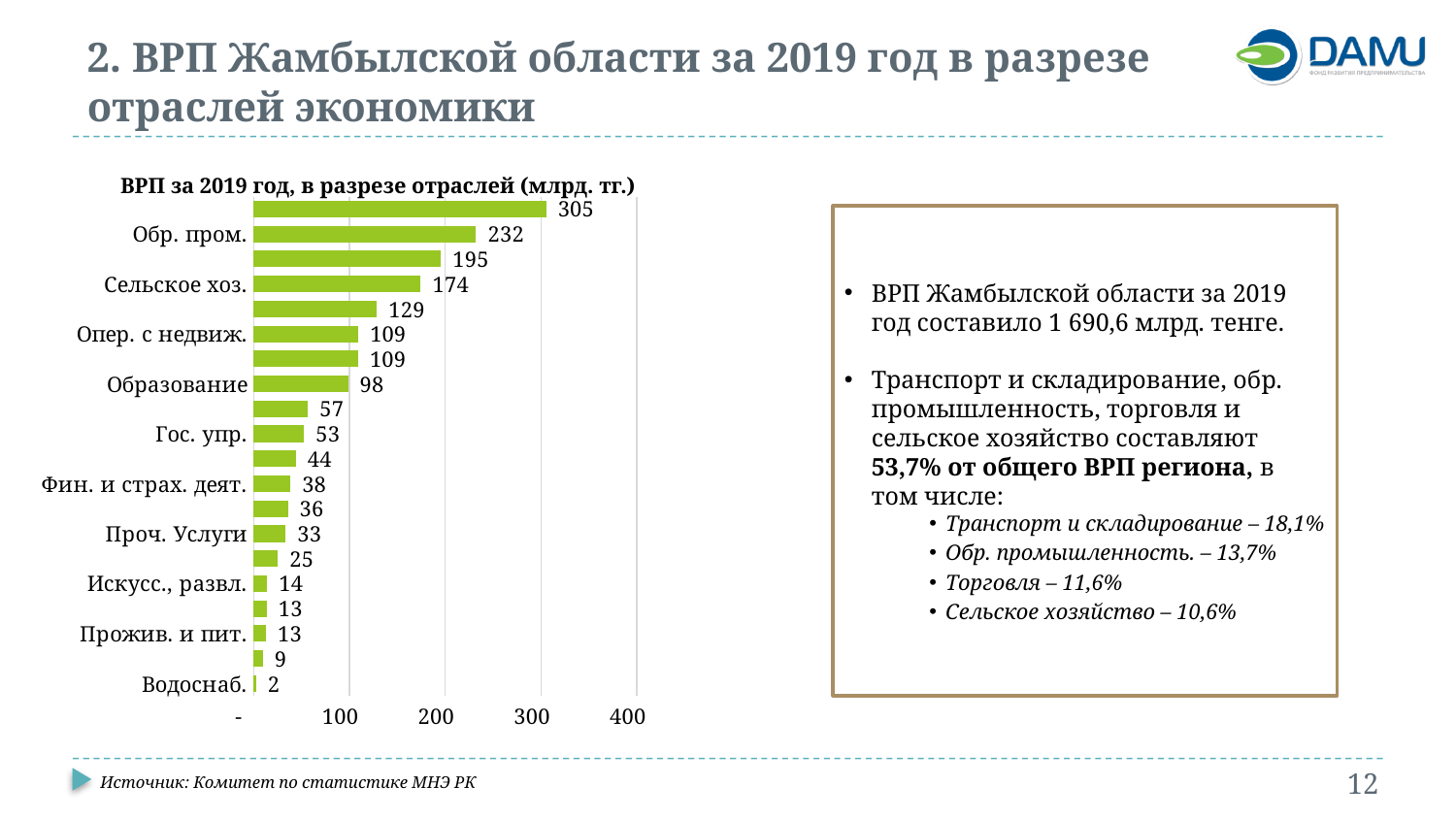
Which is larger, the value for Гос. упр. or the value for Фин. и страх. деят.? Гос. упр. What is the value for Сельское хоз. in the chart? 174 What kind of chart is shown on the slide? bar chart What is the difference between the values for Опер. с недвиж. and Образование? 11 Which labelled category has the lowest value in the chart? Водоснаб. What is the value for Обр. пром. in the chart? 232 What is the value for Водоснаб. in the chart? 2 Is the value for Обр. пром. greater or less than 200? greater What is the difference between the values for Обр. пром. and Сельское хоз.? 58 What is the value for Проч. Услуги in the chart? 33 How many bars are plotted in the chart? 20 What is the value for Образование in the chart? 98